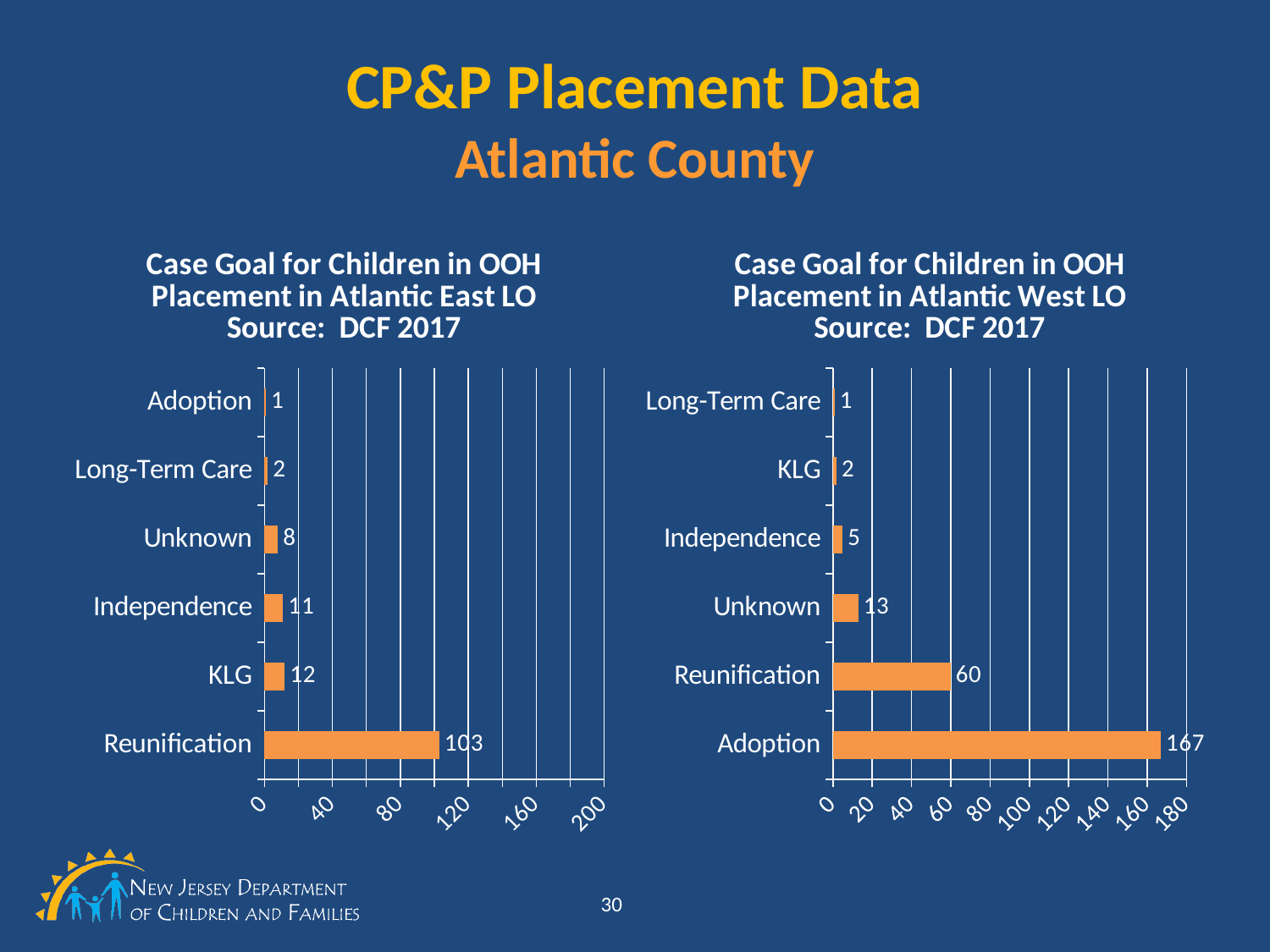
In the Atlantic West LO chart, what is the difference between Adoption and Reunification? 107 In the Atlantic West LO chart, what is the value for Adoption? 167 In the Atlantic East LO chart, which is larger, Independence or Unknown? Independence In the Atlantic East LO chart, what is the value for Reunification? 103 In the Atlantic East LO chart, what is the difference between Reunification and KLG? 91 How many categories are shown in the Atlantic West LO chart? 6 In the Atlantic West LO chart, which category has the highest value? Adoption What kind of chart is the Atlantic East LO chart? Bar chart In the Atlantic West LO chart, what is the value for Unknown? 13 What source is cited in the title of the Atlantic West LO chart? DCF 2017 In the Atlantic East LO chart, which category has the lowest value? Adoption In the Atlantic East LO chart, what is the value for KLG? 12